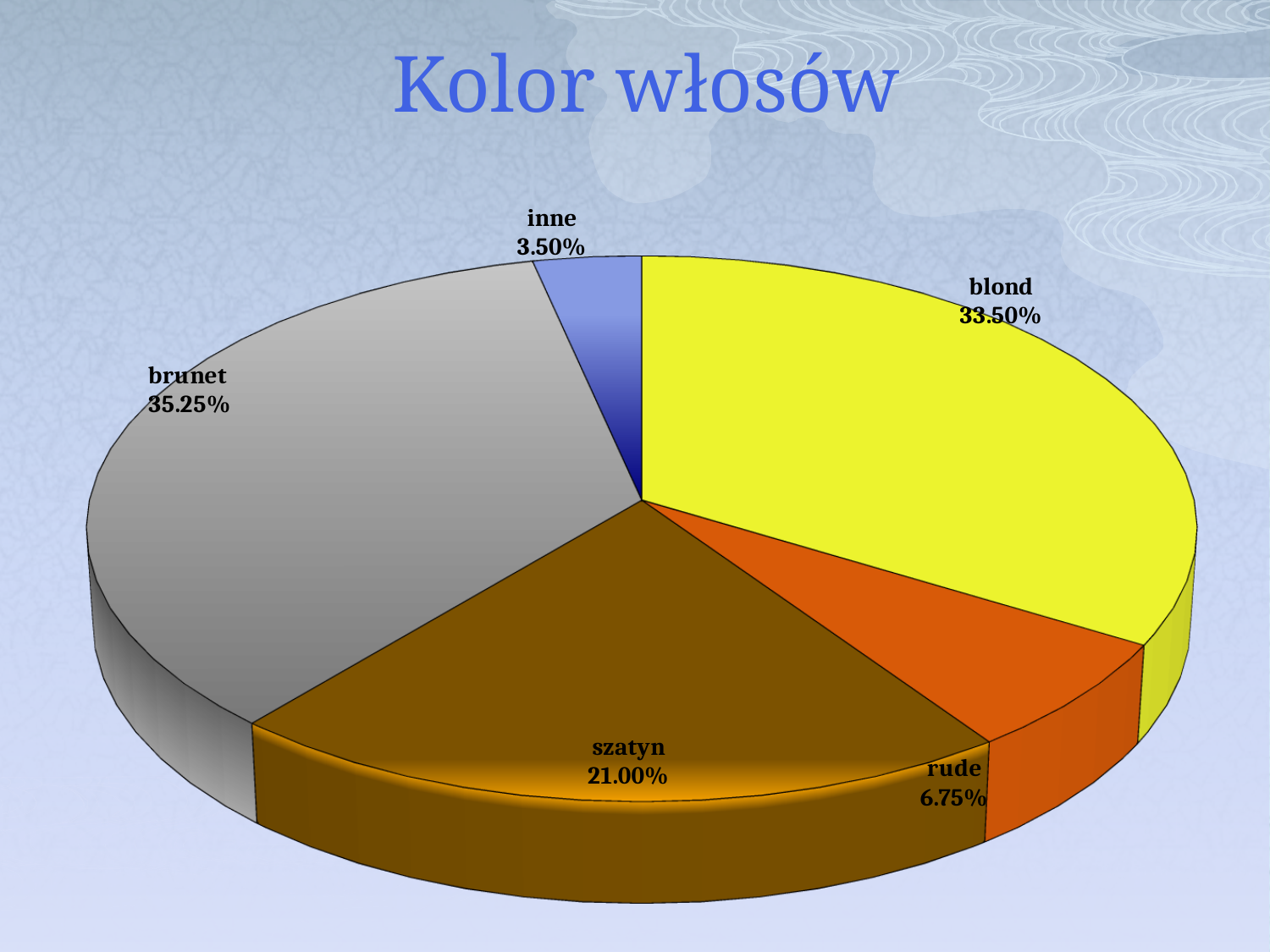
How many slices does the pie chart have? 5 What is the title of the chart? Kolor włosów Which is larger, the share for szatyn or the share for rude? szatyn What percentage of the pie is labelled blond? 33.50% What percentage of the pie is labelled rude? 6.75% What type of chart is shown on the slide? pie chart Which category has the largest share of the pie? brunet What is the difference in percentage points between brunet and blond? 1.75% What colour is the slice for blond? yellow What percentage of the pie is labelled inne? 3.50% Which category has the smallest share of the pie? inne What percentage of the pie is labelled szatyn? 21.00%